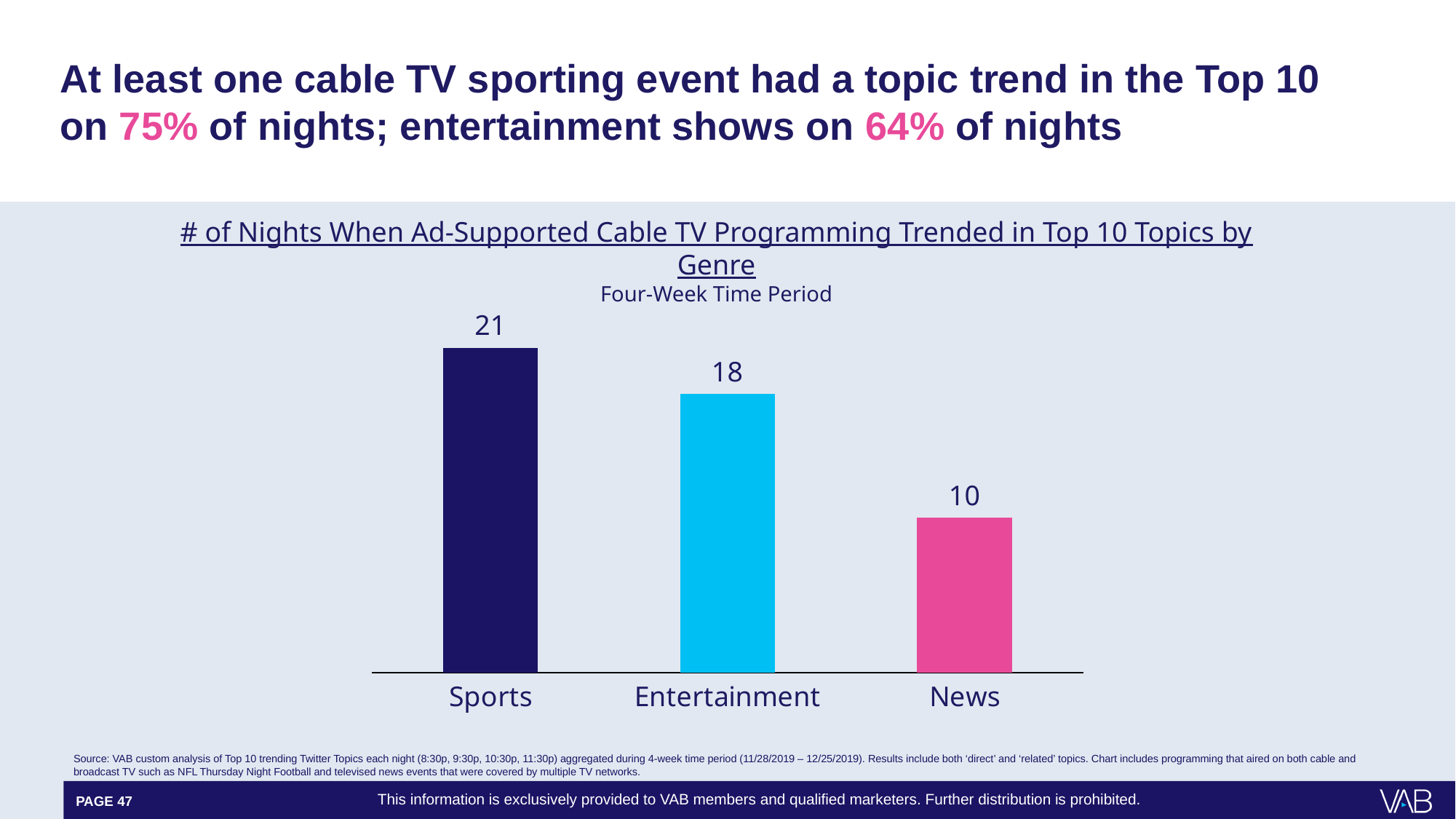
Do the values rise or fall from left to right across the genres? Fall Which has more nights, Entertainment or News? Entertainment What is the difference in nights between Entertainment and News? 8 What time period does the chart subtitle say the data covers? Four-Week Time Period Which genre has the highest number of nights? Sports How many genres are shown in the chart? 3 What is the difference in nights between Sports and Entertainment? 3 What type of chart is shown on the slide? Bar chart Which genre has the lowest number of nights? News How many nights did Entertainment programming trend in the Top 10 topics? 18 How many nights did News programming trend in the Top 10 topics? 10 How many nights did Sports programming trend in the Top 10 topics? 21